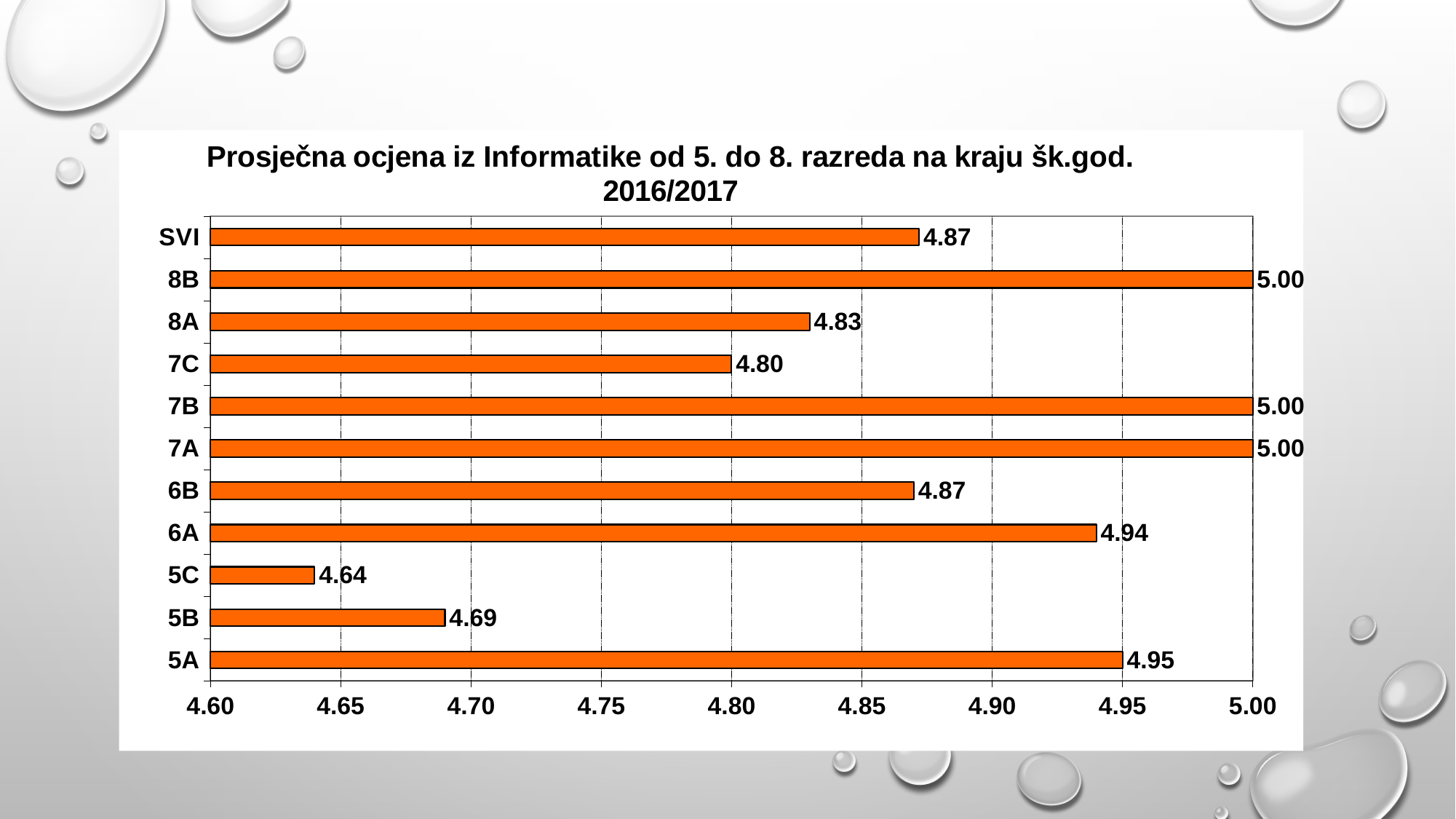
How many categories are shown on the chart? 11 Which is larger, the value for 6B or the value for 7C? 6B What is the value shown for SVI? 4.87 What kind of chart is shown on the slide? bar chart What colour are the bars in the chart? orange Which class has the lowest average grade? 5C What is the average grade for class 7C? 4.80 Is the value for 5C greater or less than 4.70? less What is the average grade for class 5A? 4.95 How many classes have an average grade of 5.00? 3 What is the difference between the values for 8B and 8A? 0.17 What is the difference between the values for 6A and 5B? 0.25